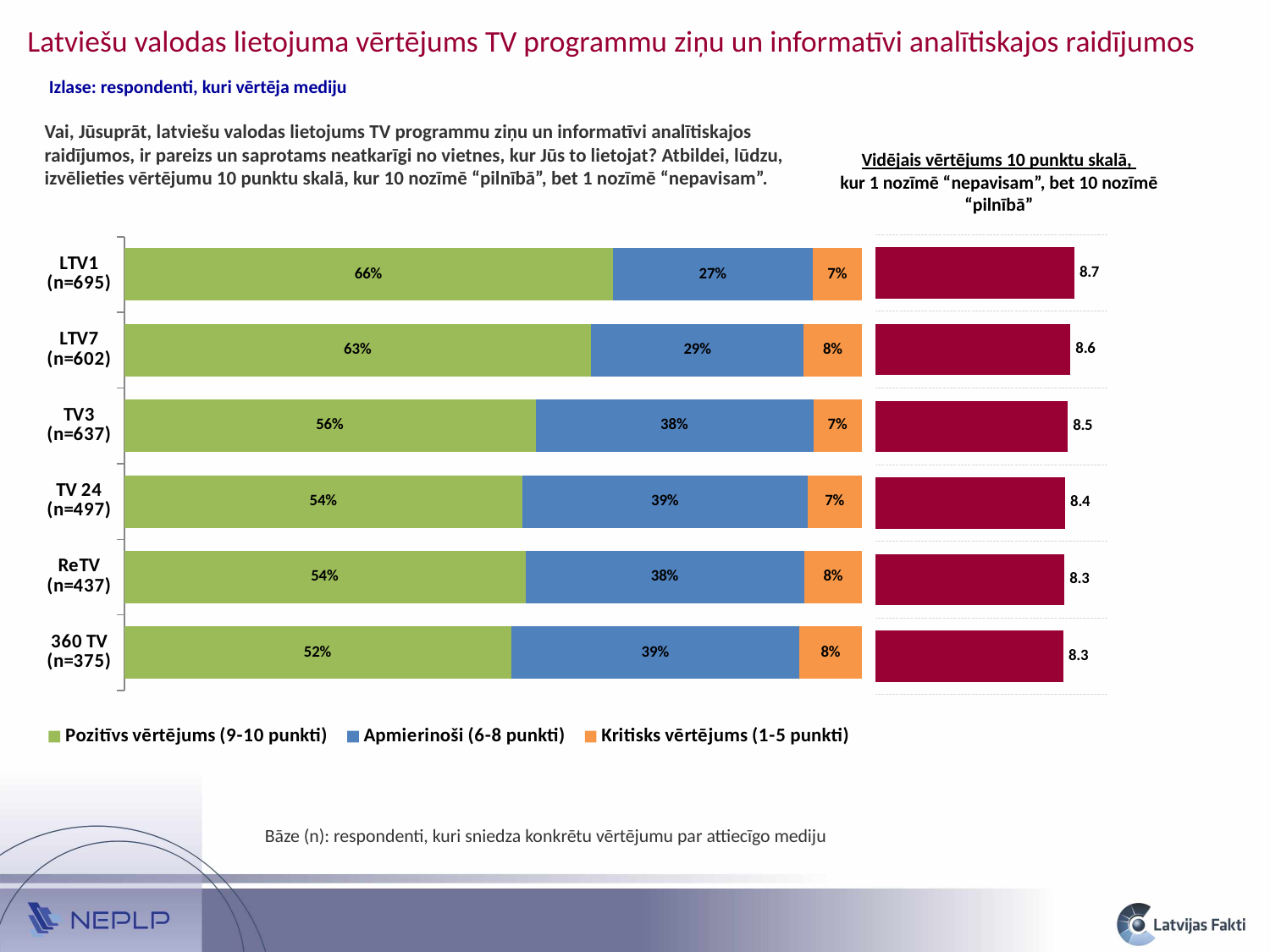
In the chart titled "Vidējais vērtējums 10 punktu skalā" on the right, what is the value for LTV7 (n=602)? 8.6 How many channels are shown in the stacked bar chart on the left? 6 In the stacked bar chart on the left, which is larger: the "Apmierinoši (6-8 punkti)" value for LTV1 or for TV 24? TV 24 In the stacked bar chart on the left, which channel has the highest "Pozitīvs vērtējums (9-10 punkti)" value? LTV1 (n=695) What kind of chart is the chart titled "Vidējais vērtējums 10 punktu skalā" on the right? Bar chart In the stacked bar chart on the left, what is the value of "Pozitīvs vērtējums (9-10 punkti)" for LTV1 (n=695)? 66% In the stacked bar chart on the left, what is the value of "Apmierinoši (6-8 punkti)" for TV3 (n=637)? 38% In the stacked bar chart on the left, which channel has the lowest "Pozitīvs vērtējums (9-10 punkti)" value? 360 TV (n=375) In the stacked bar chart on the left, what is the difference between the "Pozitīvs vērtējums (9-10 punkti)" values for LTV1 and LTV7? 3% In the stacked bar chart on the left, what is the value of "Kritisks vērtējums (1-5 punkti)" for 360 TV (n=375)? 8% How many series does the legend of the stacked bar chart on the left list? 3 In the chart titled "Vidējais vērtējums 10 punktu skalā" on the right, which channel has the highest average rating? LTV1 (n=695)